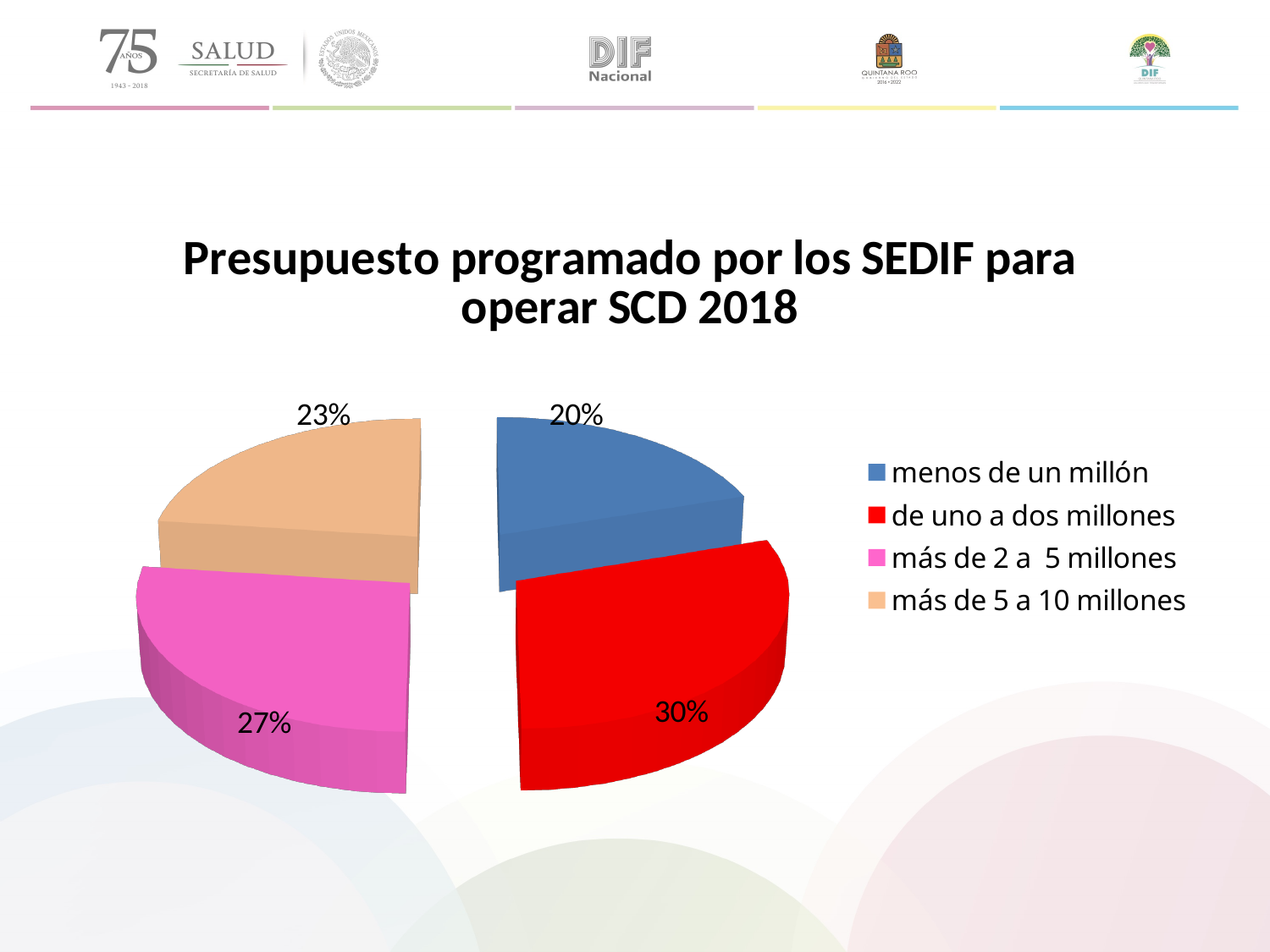
What is the title of the chart? Presupuesto programado por los SEDIF para operar SCD 2018 What percentage of the pie corresponds to 'más de 5 a 10 millones'? 23% What is the difference in percentage points between 'de uno a dos millones' and 'menos de un millón'? 10 What percentage of the pie corresponds to 'de uno a dos millones'? 30% Which is larger: the share for 'más de 2 a 5 millones' or the share for 'más de 5 a 10 millones'? más de 2 a 5 millones What type of chart is shown on the slide? Pie chart What percentage of the pie corresponds to 'más de 2 a 5 millones'? 27% Which category has the largest share of the pie? de uno a dos millones What colour is the slice for 'más de 5 a 10 millones'? Orange (light tan) Which category has the smallest share of the pie? menos de un millón How many categories does the pie chart have? 4 What percentage of the pie corresponds to 'menos de un millón'? 20%